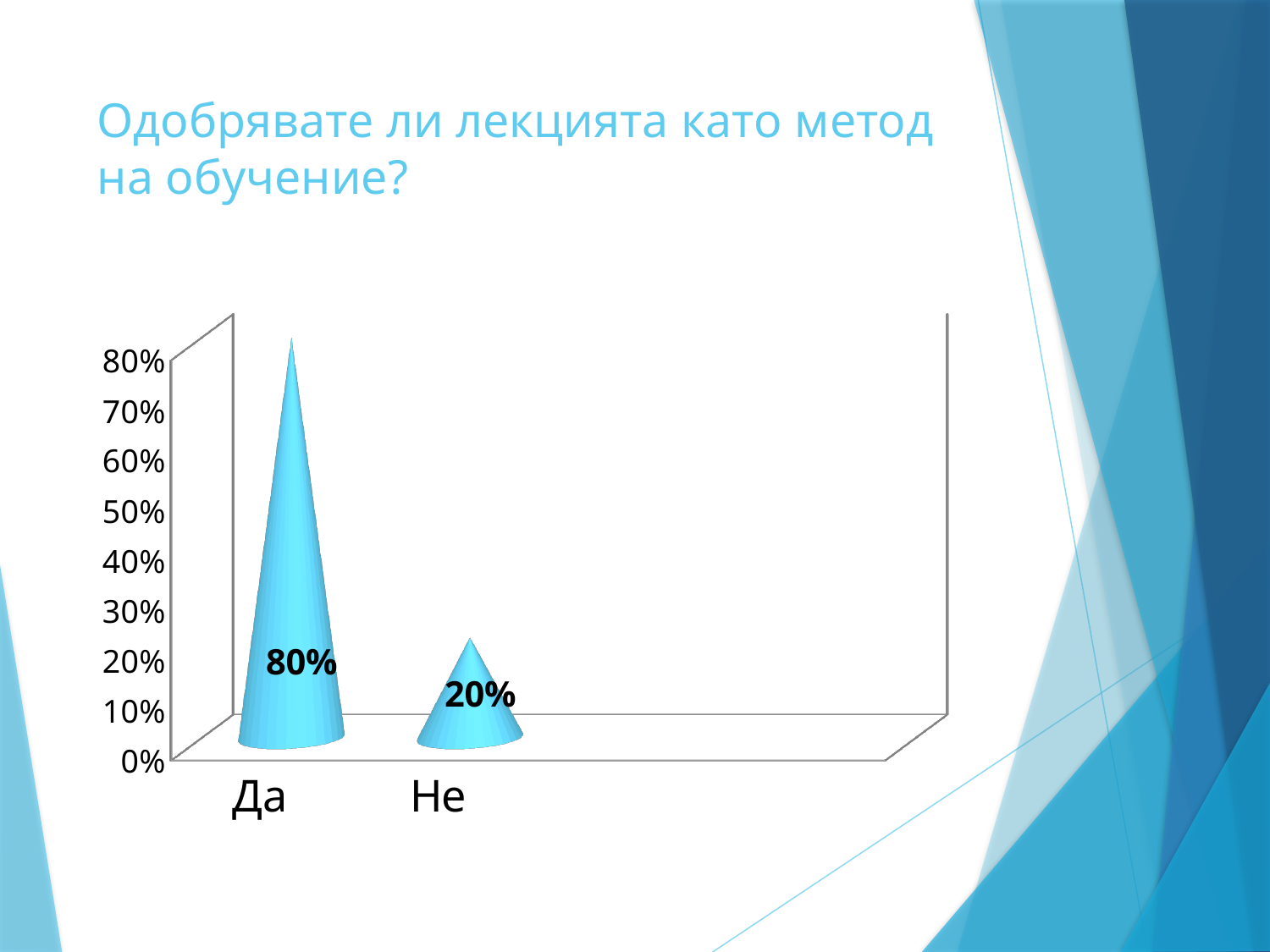
What is the highest value labelled on the vertical axis? 80% How many categories are shown on the x axis? 2 Which category has the lowest value? Не What is the title of the slide above the chart? Одобрявате ли лекцията като метод на обучение? Is the value for "Да" greater or less than 50%? greater What is the value for "Да"? 80% What is the difference between the values for "Да" and "Не"? 60% What is the value for "Не"? 20% Is the value for "Не" greater or less than 50%? less What kind of chart is shown on the slide? bar chart Which category has the highest value? Да Which is larger, the value for "Да" or the value for "Не"? Да